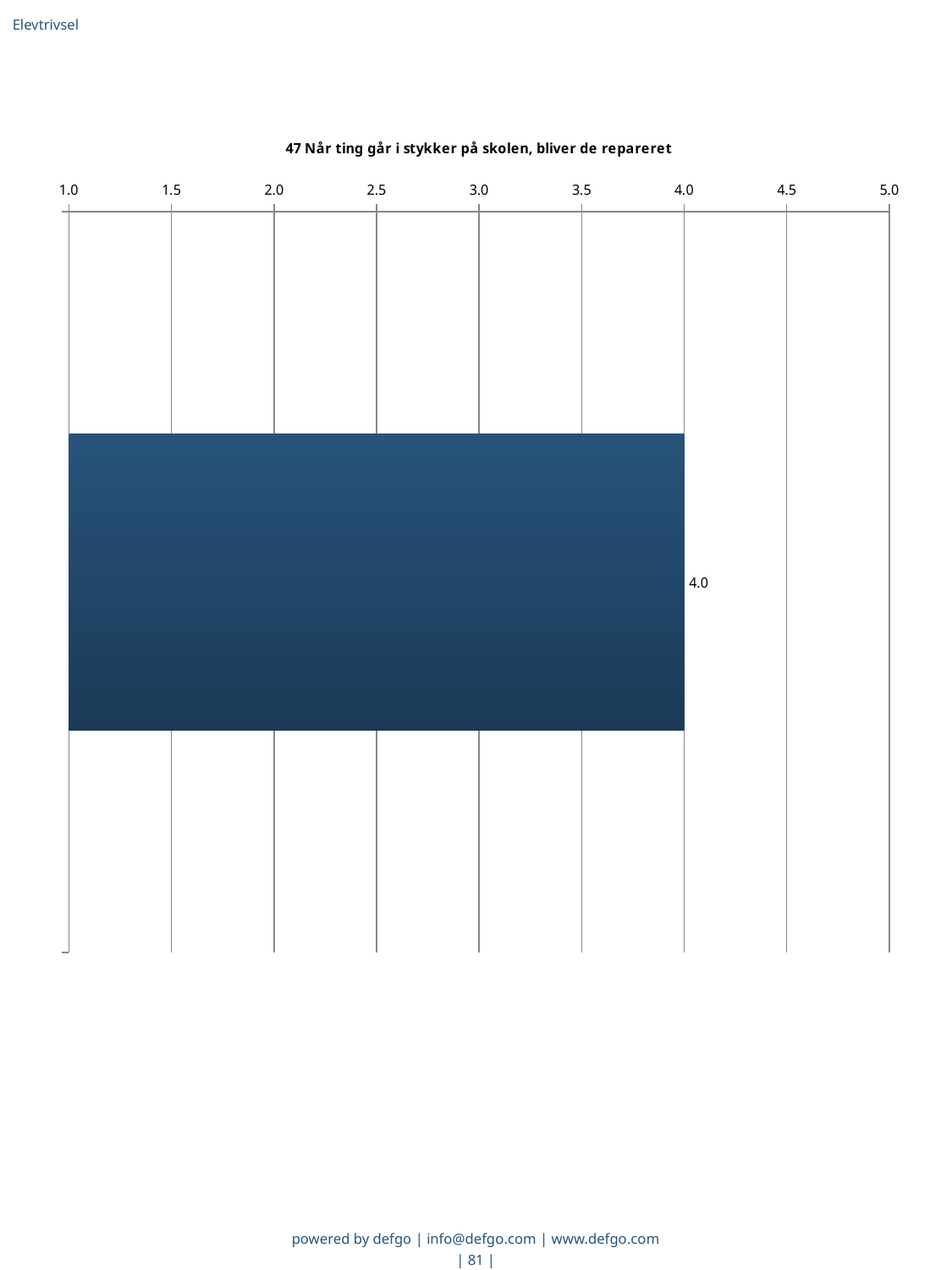
What is the title of the chart? 47 Når ting går i stykker på skolen, bliver de repareret What is the maximum value shown on the chart's axis? 5.0 What kind of chart is shown on the slide? bar chart What value is shown by the single bar in the chart? 4.0 Is the value of the bar greater or less than 4.5? less How many bars are plotted in the chart? 1 What is the minimum value shown on the chart's axis? 1.0 Is the value of the bar greater or less than 3.5? greater